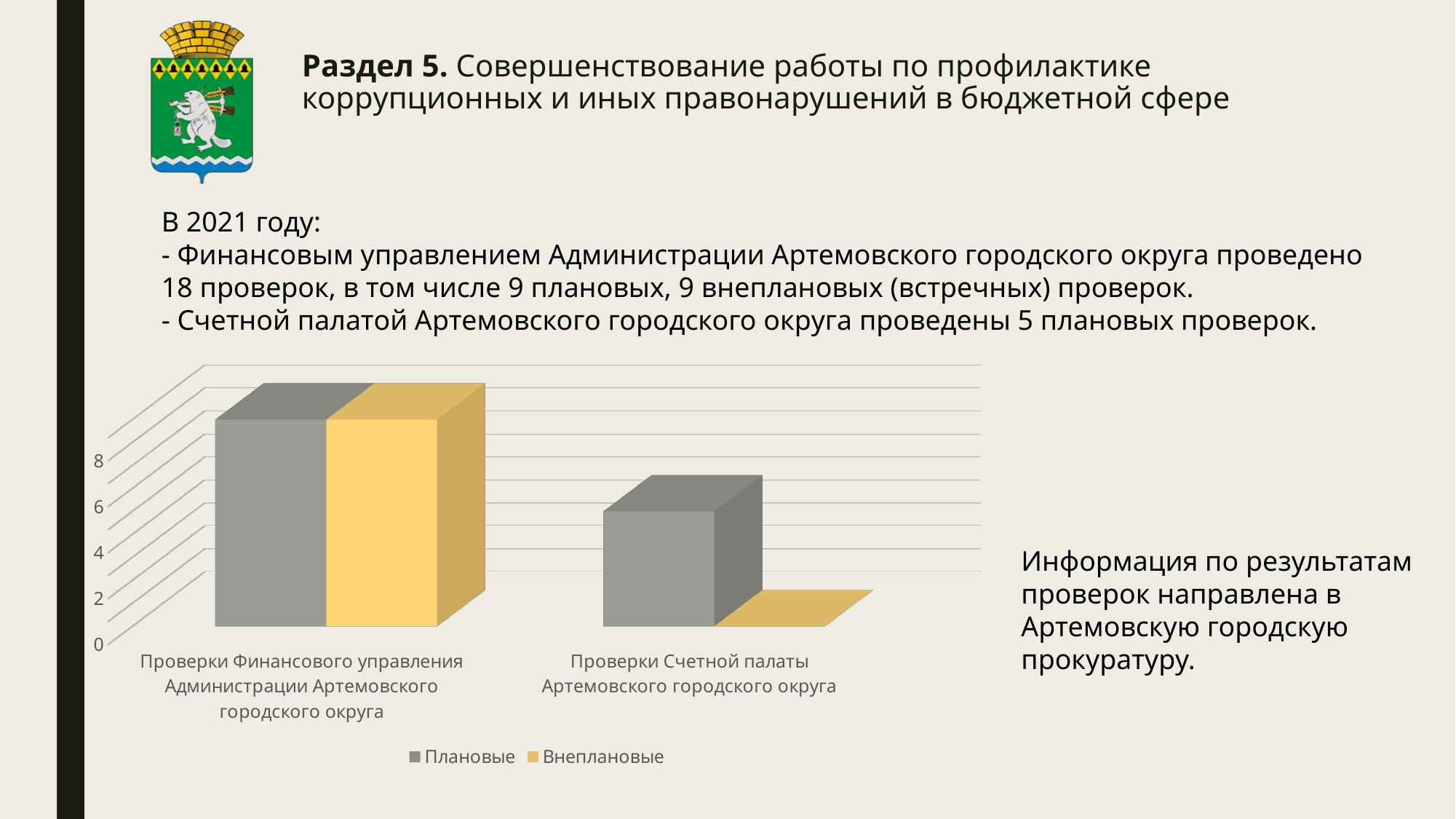
What colour represents the Внеплановые series in the chart? yellow Is the value for Плановые for Проверки Финансового управления Администрации Артемовского городского округа greater or less than 8? greater Is the value for Внеплановые for Проверки Счетной палаты Артемовского городского округа greater or less than 2? less Is the value for Плановые for Проверки Счетной палаты Артемовского городского округа greater or less than 8? less How many series does the chart legend list? 2 How many categories are shown on the x axis of the chart? 2 According to the slide text, how many плановых проверок did the Финансовое управление conduct in 2021? 9 What are the two series named in the chart legend? Плановые, Внеплановые What kind of chart is shown on the slide? bar chart Which category has the larger Плановые value: Проверки Финансового управления or Проверки Счетной палаты? Проверки Финансового управления Администрации Артемовского городского округа Which category has the lowest Внеплановые value? Проверки Счетной палаты Артемовского городского округа